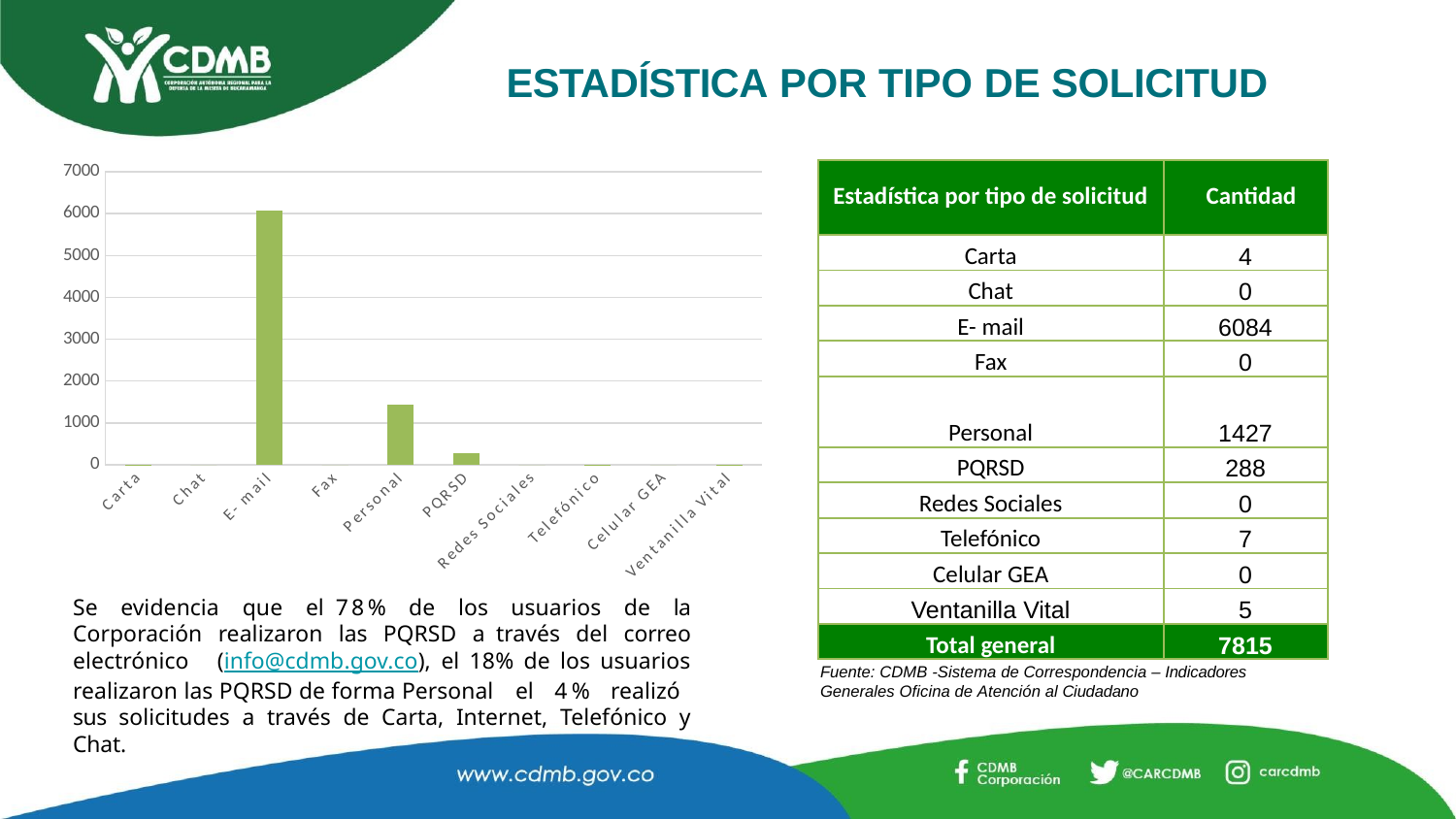
How many categories are shown on the x axis of the chart? 10 Is the value for E- mail greater or less than 5000? greater Which is larger, the value for Personal or the value for PQRSD? Personal What is the highest value shown on the chart's vertical axis? 7000 What kind of chart is shown on the slide? bar chart Which category has the highest bar in the chart? E- mail Which is larger, the value for E- mail or the value for Personal? E- mail According to the slide, what is the value for E- mail? 6084 According to the slide, what is the value for Personal? 1427 Is the value for PQRSD greater or less than 1000? less Is the value for Personal greater or less than 1000? greater What is the difference between the values for E- mail and Personal shown on the slide? 4657